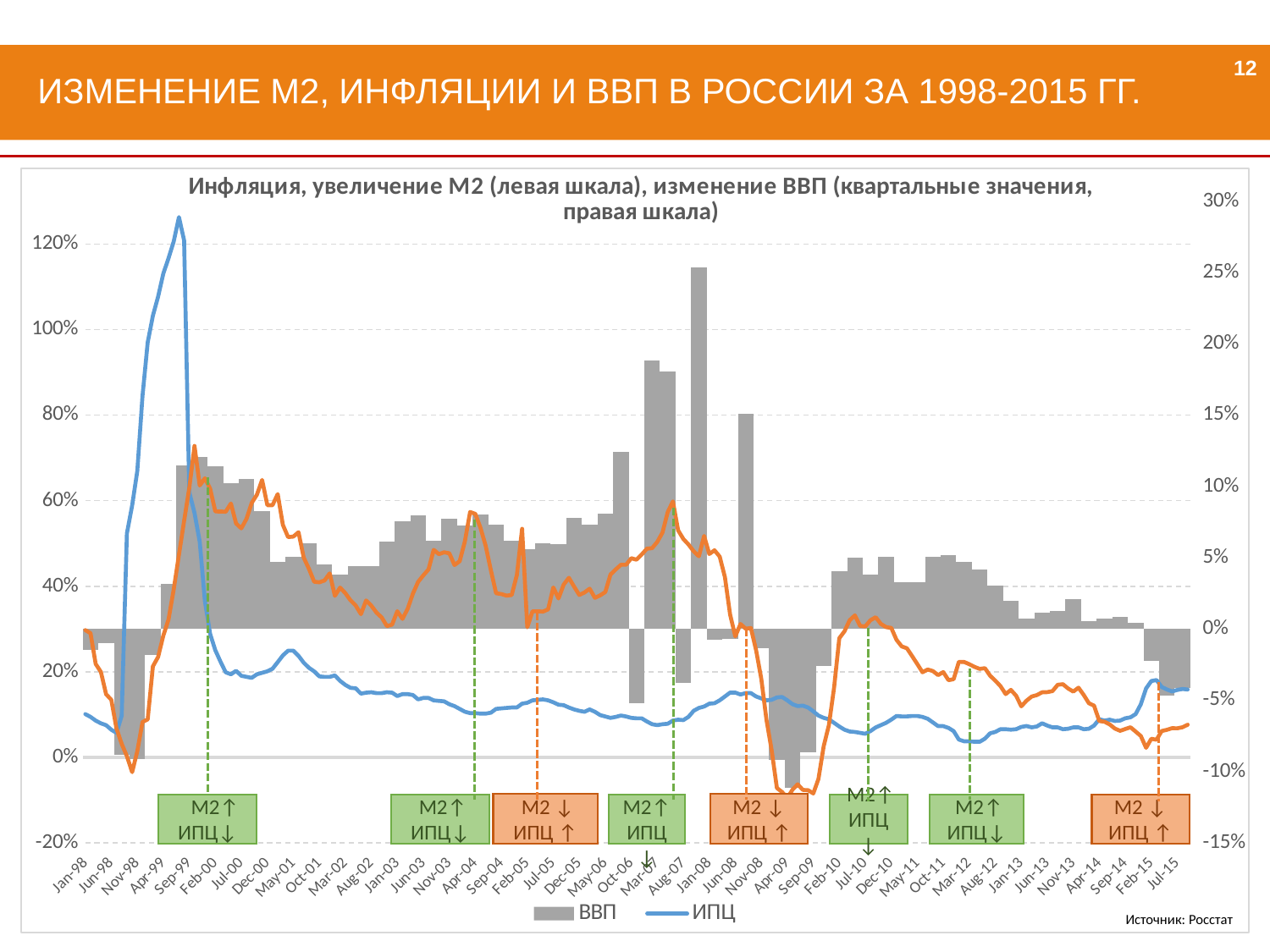
Is the value of the ИПЦ line at Jan-98 (left scale) greater or less than 20%? less Does the ИПЦ line rise or fall between Apr-99 and Feb-00? fall Is the tallest ВВП bar (right scale) greater or less than 20%? greater Is the peak value of the ИПЦ line (left scale) greater or less than 120%? greater Which is higher on the left scale at Jan-98: the ИПЦ line or the orange M2 line? the orange M2 line What source is cited for the chart? Росстат What is the title of the chart? Инфляция, увеличение М2 (левая шкала), изменение ВВП (квартальные значения, правая шкала) What kind of chart is shown on the slide? A combination chart of bars and lines Does the ИПЦ line rise or fall between Jan-98 and Apr-99? rise Around which period does the ИПЦ line reach its highest value? Sep-99 How many series does the chart legend list? 2